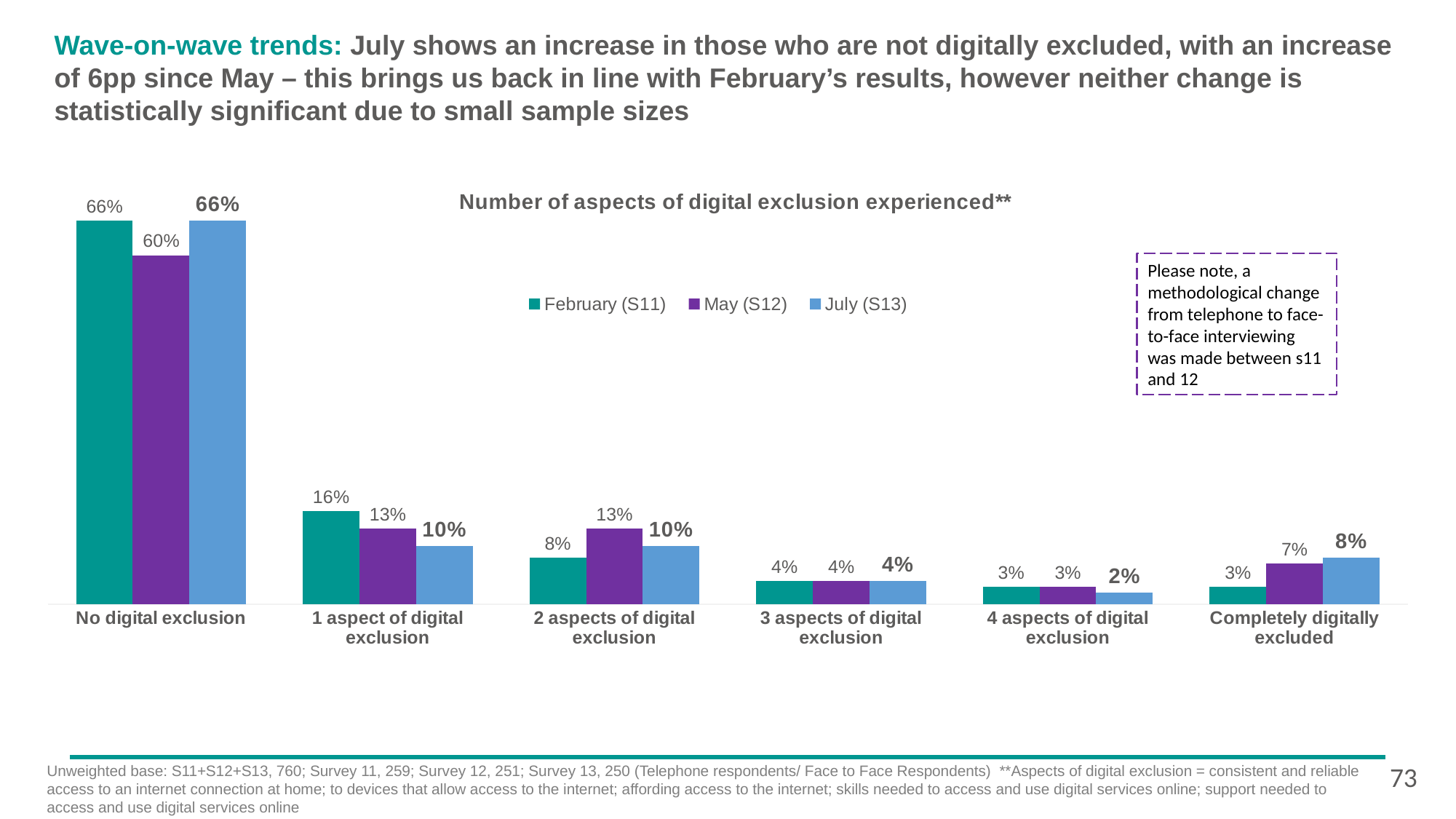
What is the value for May (S12) in the 'No digital exclusion' category? 60% What is the value for July (S13) in the 'Completely digitally excluded' category? 8% What is the title of the chart? Number of aspects of digital exclusion experienced** Which is larger in the 'Completely digitally excluded' category: February (S11) or May (S12)? May (S12) How many series does the legend list? 3 How many categories are shown on the x axis? 6 What is the value for July (S13) in the '1 aspect of digital exclusion' category? 10% Which category has the lowest value for July (S13)? 4 aspects of digital exclusion Which category has the highest value for July (S13)? No digital exclusion What is the difference between the February (S11) and July (S13) values for '1 aspect of digital exclusion'? 6% What kind of chart is shown on the slide? Bar chart What is the value for February (S11) in the '2 aspects of digital exclusion' category? 8%